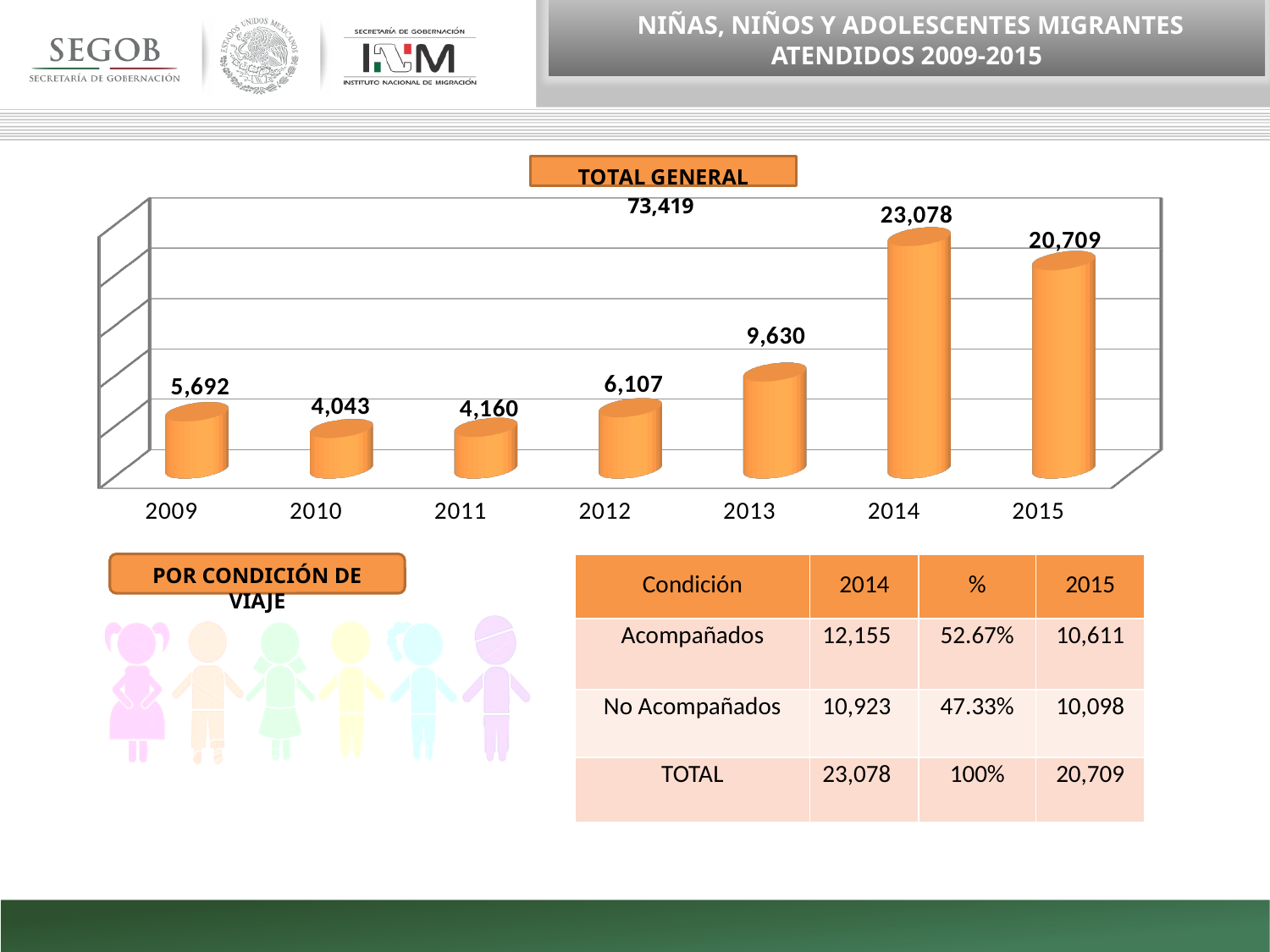
How many years are plotted in the chart? 7 Do the values rise or fall from 2012 to 2014? Rise Which is larger, the value for 2011 or the value for 2010? 2011 What kind of chart is shown on the slide? Bar chart What is the difference between the values for 2014 and 2015? 2,369 What is the difference between the values for 2012 and 2011? 1,947 What value is shown for 2009 in the chart? 5,692 Which year has the lowest value in the chart? 2010 What value is shown for 2014 in the chart? 23,078 What is the title shown above the chart? TOTAL GENERAL What value is shown for 2013 in the chart? 9,630 Which year has the highest value in the chart? 2014